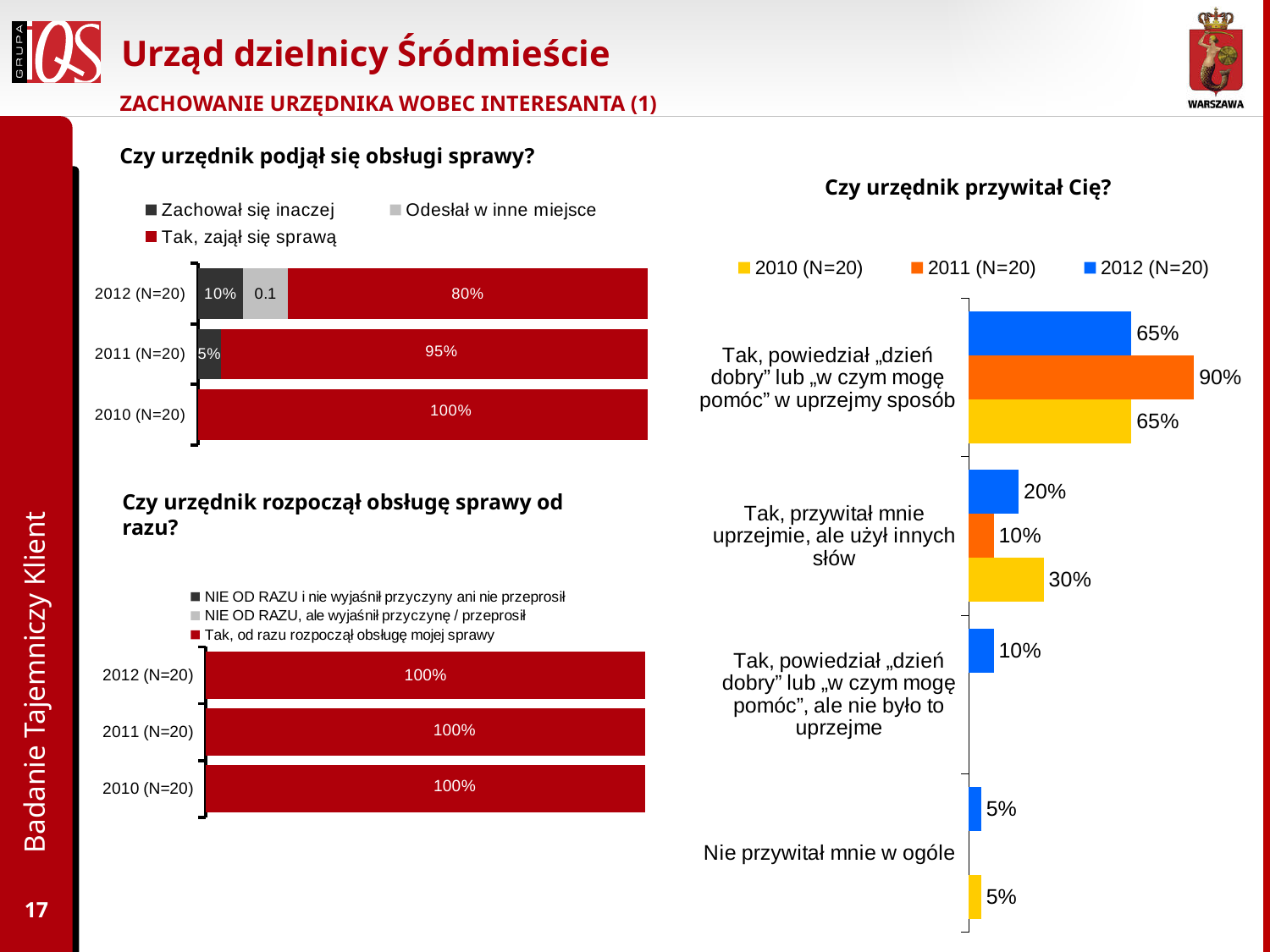
In the chart 'Czy urzędnik podjął się obsługi sprawy?', what is the value for 'Tak, zajął się sprawą' in 2012 (N=20)? 80% In the chart 'Czy urzędnik podjął się obsługi sprawy?', what is the value for 'Tak, zajął się sprawą' in 2011 (N=20)? 95% In the chart 'Czy urzędnik przywitał Cię?', what is the value for 2010 (N=20) in the category 'Tak, przywitał mnie uprzejmie, ale użył innych słów'? 30% In the chart 'Czy urzędnik podjął się obsługi sprawy?', which year has the highest value for 'Tak, zajął się sprawą'? 2010 (N=20) In the chart 'Czy urzędnik przywitał Cię?', which is larger for 'Tak, przywitał mnie uprzejmie, ale użył innych słów': 2012 (N=20) or 2011 (N=20)? 2012 (N=20) What kind of chart is 'Czy urzędnik rozpoczął obsługę sprawy od razu?'? Bar chart In the chart 'Czy urzędnik rozpoczął obsługę sprawy od razu?', what is the value for 'Tak, od razu rozpoczął obsługę mojej sprawy' in 2011 (N=20)? 100% In the chart 'Czy urzędnik przywitał Cię?', how many categories are shown on the vertical axis? 4 In the chart 'Czy urzędnik przywitał Cię?', what is the difference between the 2011 (N=20) and 2012 (N=20) values for 'Tak, powiedział „dzień dobry” lub „w czym mogę pomóc” w uprzejmy sposób'? 25% In the chart 'Czy urzędnik podjął się obsługi sprawy?', what is the value for 'Zachował się inaczej' in 2012 (N=20)? 10% In the chart 'Czy urzędnik przywitał Cię?', what is the value for 2011 (N=20) in the category 'Tak, powiedział „dzień dobry” lub „w czym mogę pomóc” w uprzejmy sposób'? 90% In the chart 'Czy urzędnik podjął się obsługi sprawy?', how many series does the legend list? 3